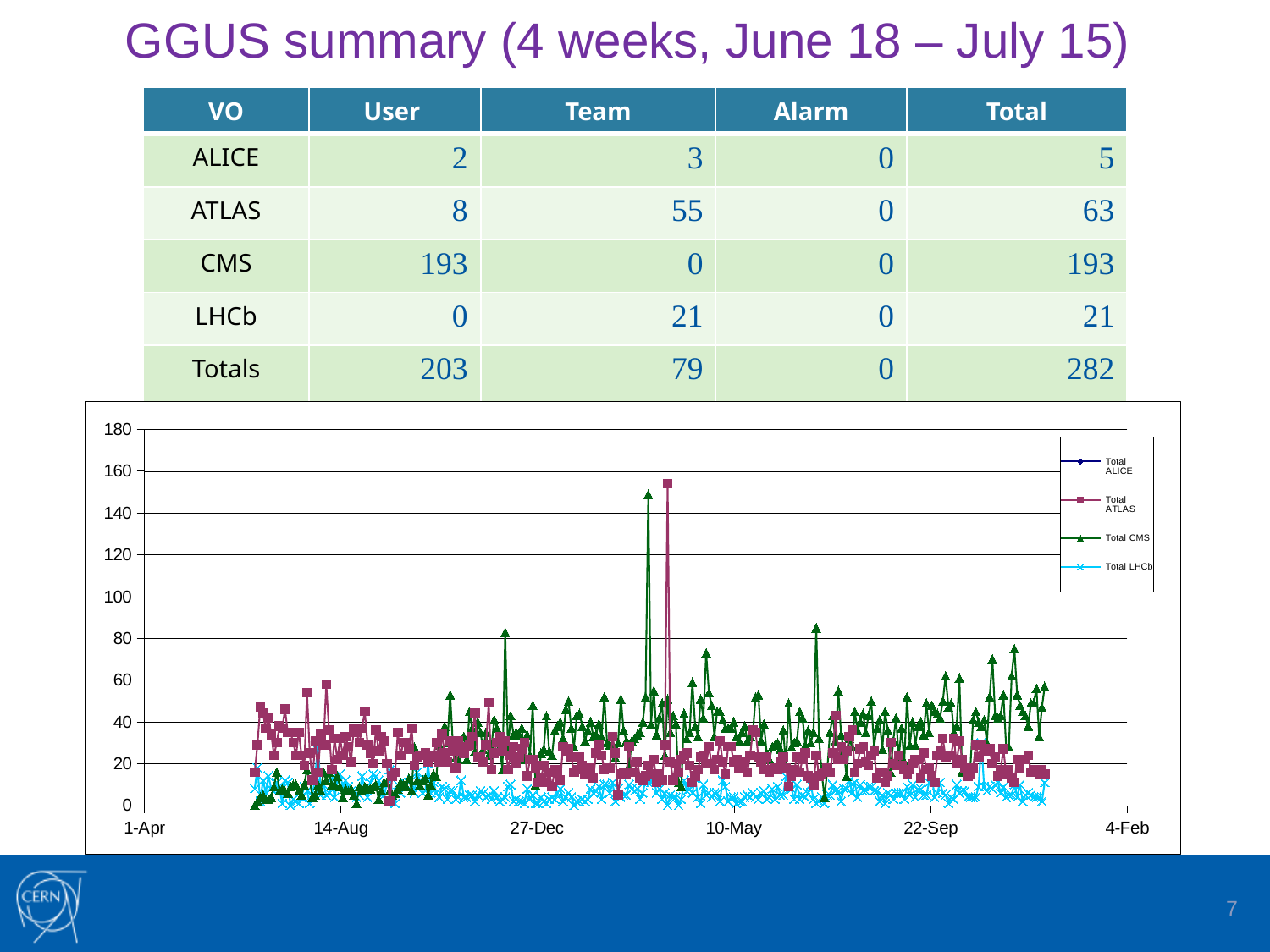
Which series reaches the single highest point on the chart? Total ATLAS Near the 22-Sep tick, which series is larger: Total CMS or Total ATLAS? Total CMS What is the highest value shown on the chart's y axis? 180 Is the highest value reached by the Total LHCb series greater or less than 40? less Which series does the legend show with a green triangle marker? Total CMS What kind of chart is shown below the table? line chart Is the highest value reached by the Total CMS series greater or less than 100? greater How many date labels are shown along the chart's x axis? 6 Is the highest value reached by the Total ATLAS series greater or less than 140? greater Near the 22-Sep tick, which series is larger: Total CMS or Total LHCb? Total CMS How many series does the chart's legend list? 4